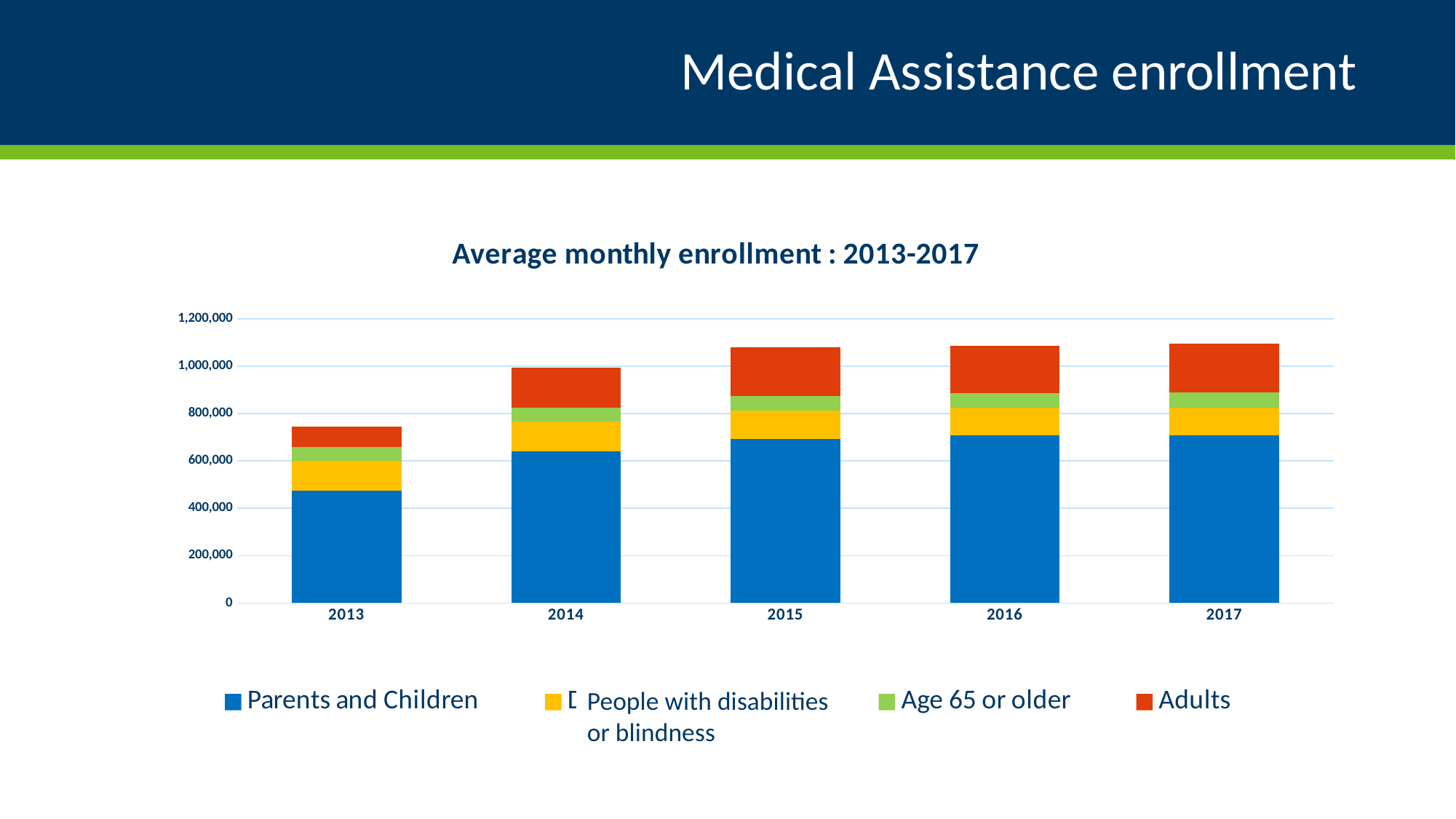
Is the total enrollment for 2013 greater or less than 800,000? less Does the total enrollment generally rise or fall from 2013 to 2017? Rise Is the Parents and Children value for 2013 greater or less than 600,000? less Which year has the lowest total enrollment in the chart? 2013 What is the title of the chart? Average monthly enrollment : 2013-2017 How many series does the chart's legend list? 4 Is the Parents and Children value for 2017 greater or less than 600,000? greater Which year has the larger total enrollment, 2013 or 2014? 2014 What kind of chart is shown on the slide? Stacked bar chart How many years are shown on the x axis of the chart? 5 Which colour represents the Adults series in the chart? Red